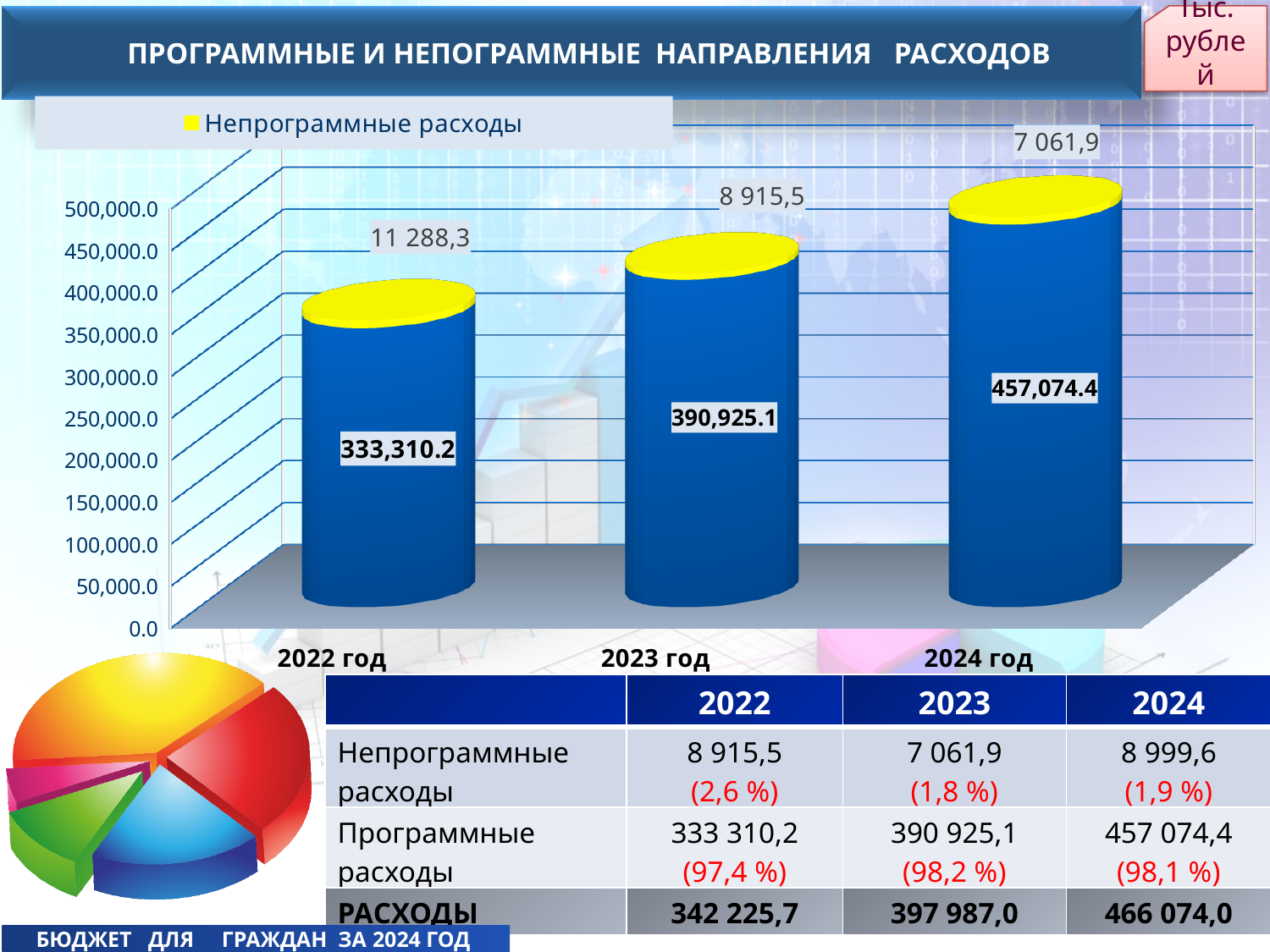
What is the value of programmatic expenses (blue segment) for 2024 год? 457,074.4 Which year has the lowest programmatic expenses (blue segment)? 2022 год What is the value of programmatic expenses (blue segment) for 2023 год? 390,925.1 What is the difference between the programmatic expenses for 2023 год and 2022 год? 57,614.9 What is the difference between the programmatic expenses for 2024 год and 2023 год? 66,149.3 Do the programmatic expenses rise or fall from 2022 год to 2024 год? rise Which is larger, the programmatic expenses for 2022 год or for 2023 год? 2023 год Is the programmatic expenses value for 2022 год greater or less than 300,000.0? greater How many years are shown on the x axis of the chart? 3 Which year has the highest programmatic expenses (blue segment)? 2024 год What is the value of programmatic expenses (blue segment) for 2022 год? 333,310.2 What kind of chart is shown on the slide? bar chart